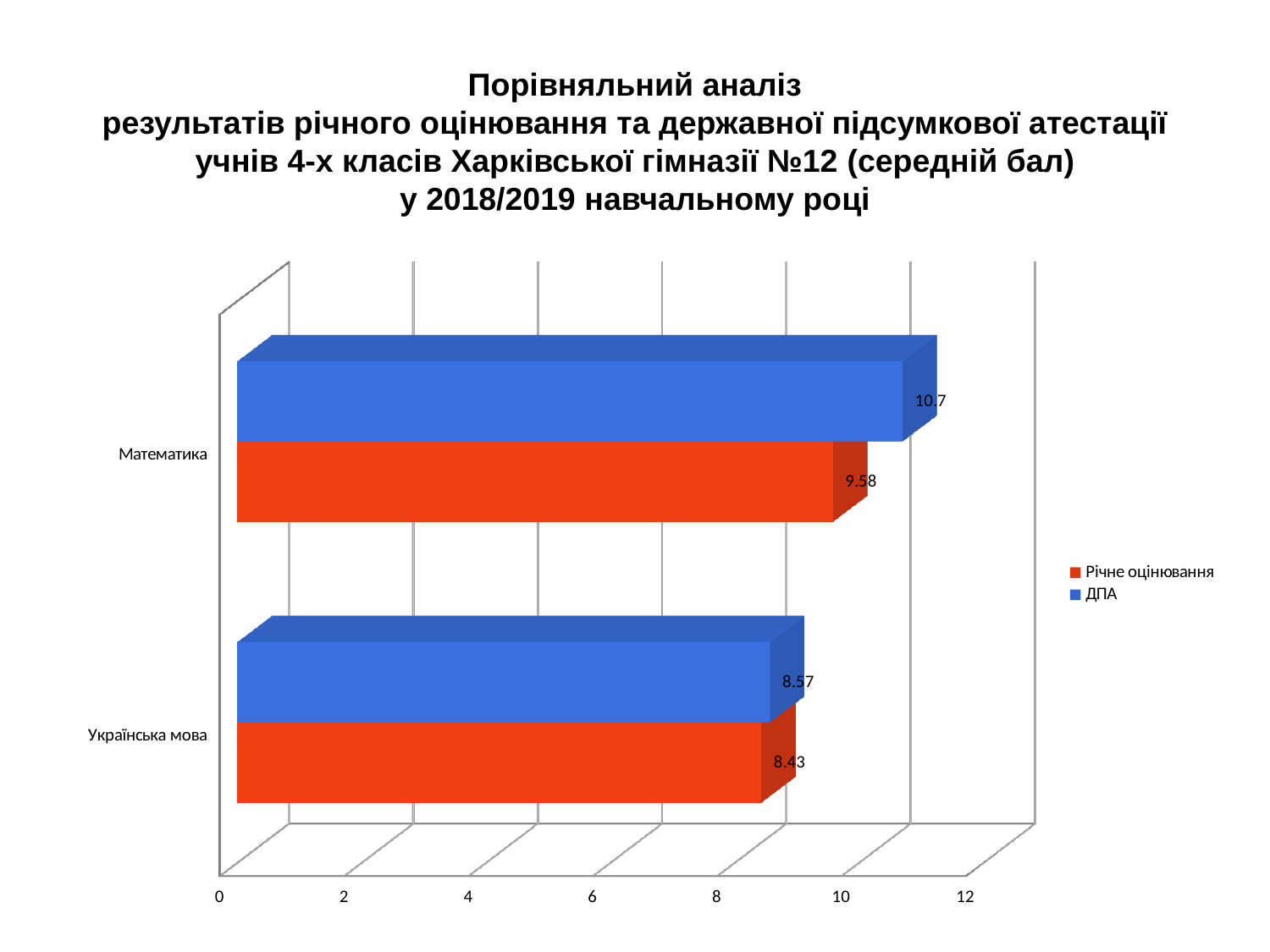
What is the ДПА value for Математика? 10.7 How many subjects are shown on the chart? 2 How many series does the legend list? 2 Is the ДПА value for Математика greater or less than 10? greater Which subject has the highest ДПА value? Математика Which subject has the lowest Річне оцінювання value? Українська мова What is the Річне оцінювання value for Українська мова? 8.43 Which is larger for Математика: the ДПА value or the Річне оцінювання value? ДПА What is the difference between the ДПА and Річне оцінювання values for Математика? 1.12 What is the Річне оцінювання value for Математика? 9.58 What kind of chart is shown on the slide? Bar chart What is the ДПА value for Українська мова? 8.57